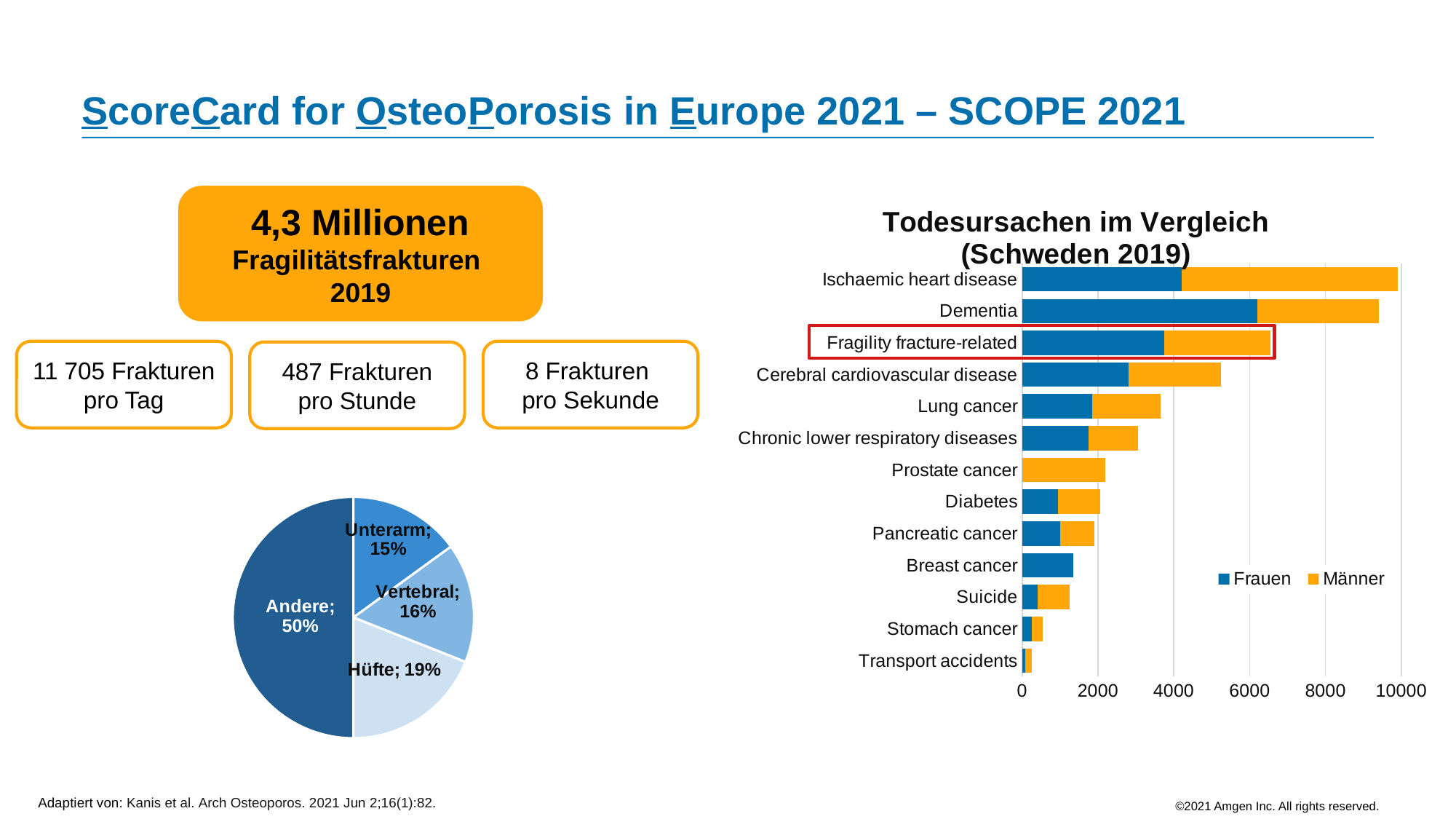
How many series does the legend of 'Todesursachen im Vergleich (Schweden 2019)' list? 2 In the pie chart at the bottom left, which slice is the largest? Andere How many causes of death are shown in 'Todesursachen im Vergleich (Schweden 2019)'? 13 In the pie chart at the bottom left, what is the difference in percentage points between Hüfte and Unterarm? 4 In 'Todesursachen im Vergleich (Schweden 2019)', which is larger, the total bar for Lung cancer or for Diabetes? Lung cancer In the pie chart at the bottom left, how many slices are there? 4 In the pie chart at the bottom left, what share does Hüfte have? 19% In the pie chart at the bottom left, what share does Vertebral have? 16% In 'Todesursachen im Vergleich (Schweden 2019)', which cause of death has the longest total bar? Ischaemic heart disease In 'Todesursachen im Vergleich (Schweden 2019)', is the total bar for Fragility fracture-related greater or less than 6000? greater What kind of chart is 'Todesursachen im Vergleich (Schweden 2019)'? Stacked bar chart In the pie chart at the bottom left, which slice is the smallest? Unterarm